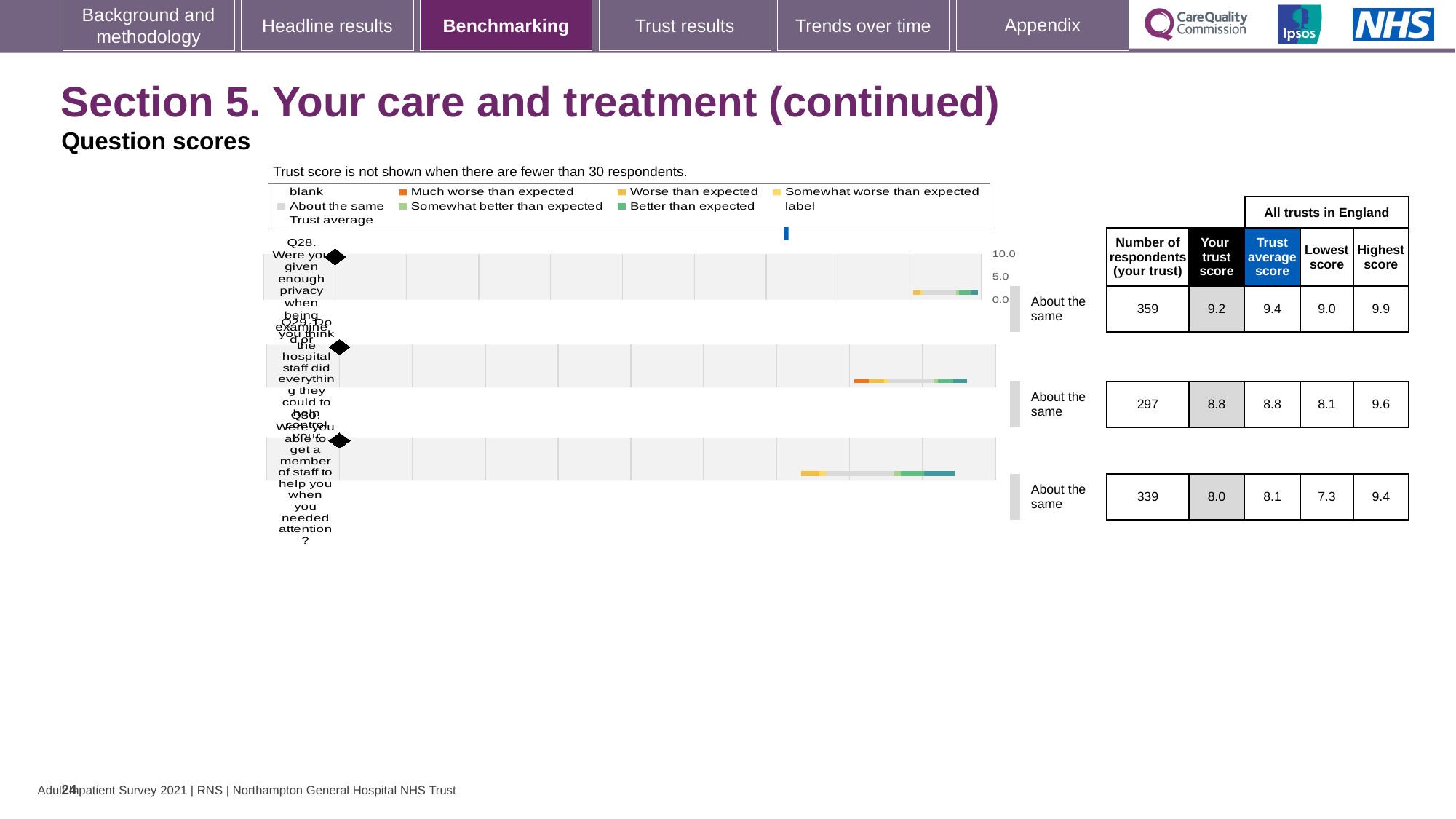
How many questions (Q28, Q29, Q30) are charted on this slide? 3 What benchmark category is shown next to the Q29 chart? About the same How many respondents answered Q29 (Do you think the hospital staff did everything they could to help control your pain)? 297 What is the trust score for Q28 (Were you given enough privacy when being examined or treated)? 9.2 For Q30, which is larger: the trust score or the trust average score? Trust average score Which question has the lowest trust score on this slide? Q30 What is the difference between the highest score (9.9) and the lowest score (9.0) for Q28? 0.9 What kind of chart is used to show the question scores on this slide? bar chart What is the lowest score across all trusts in England for Q30 (Were you able to get a member of staff to help you when you needed attention)? 7.3 What is the highest score across all trusts in England for Q30? 9.4 Which question has the highest trust score on this slide? Q28